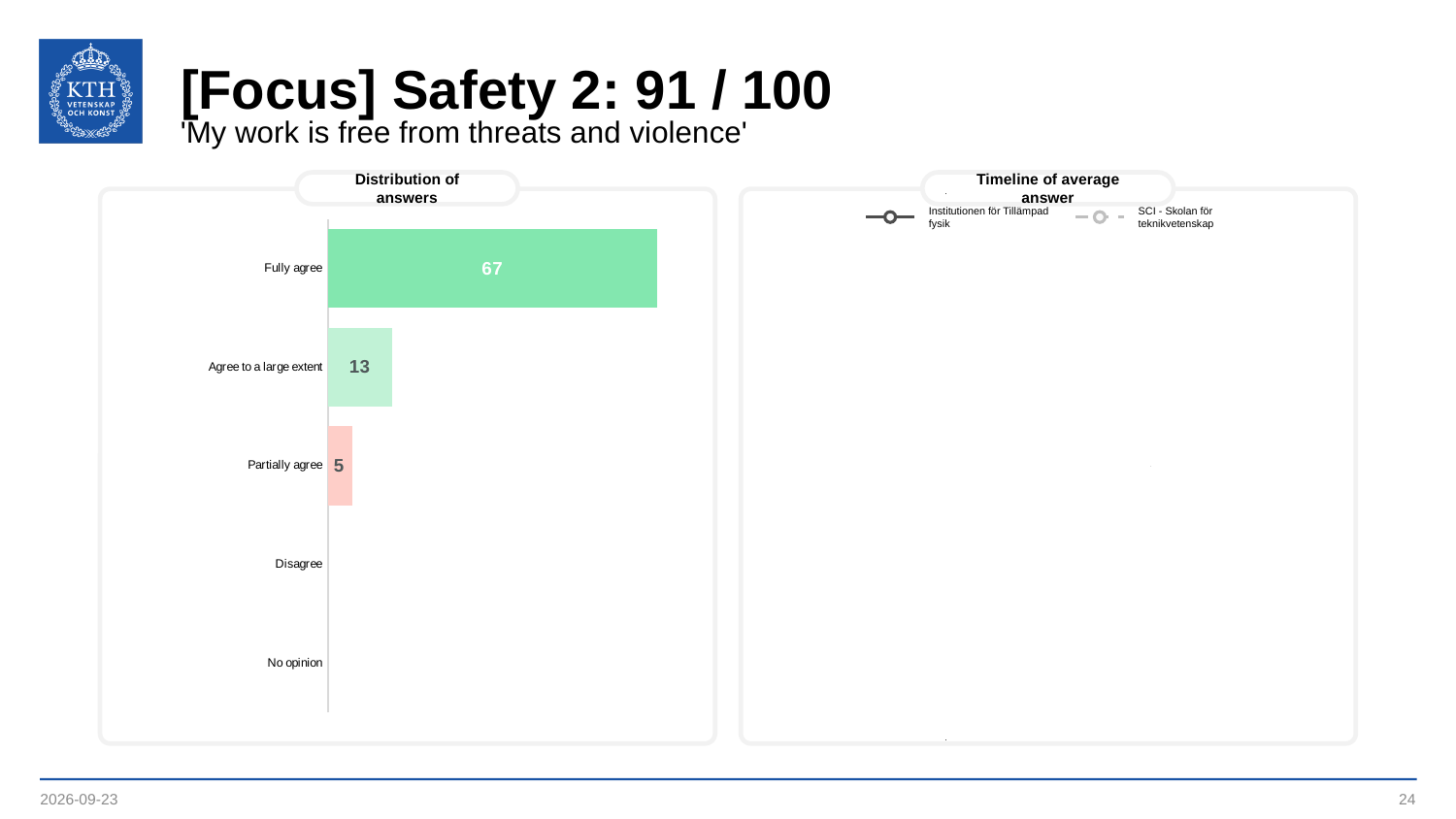
In the 'Distribution of answers' chart, what is the difference between the values for 'Fully agree' and 'Agree to a large extent'? 54 In the 'Distribution of answers' chart, do the values rise or fall going from 'Fully agree' down to 'Partially agree'? Fall What are the two legend entries in the 'Timeline of average answer' chart? Institutionen för Tillämpad fysik; SCI - Skolan för teknikvetenskap In the 'Distribution of answers' chart, what is the value for 'Fully agree'? 67 In the 'Distribution of answers' chart, what is the difference between the values for 'Agree to a large extent' and 'Partially agree'? 8 How many categories are listed on the axis of the 'Distribution of answers' chart? 5 In the 'Distribution of answers' chart, what is the value for 'Partially agree'? 5 In the 'Distribution of answers' chart, which is larger: the value for 'Agree to a large extent' or the value for 'Partially agree'? Agree to a large extent In the 'Distribution of answers' chart, what is the value for 'Agree to a large extent'? 13 In the 'Distribution of answers' chart, which category has the highest value? Fully agree What kind of chart is the 'Distribution of answers' chart? Bar chart How many series does the legend of the 'Timeline of average answer' chart list? 2